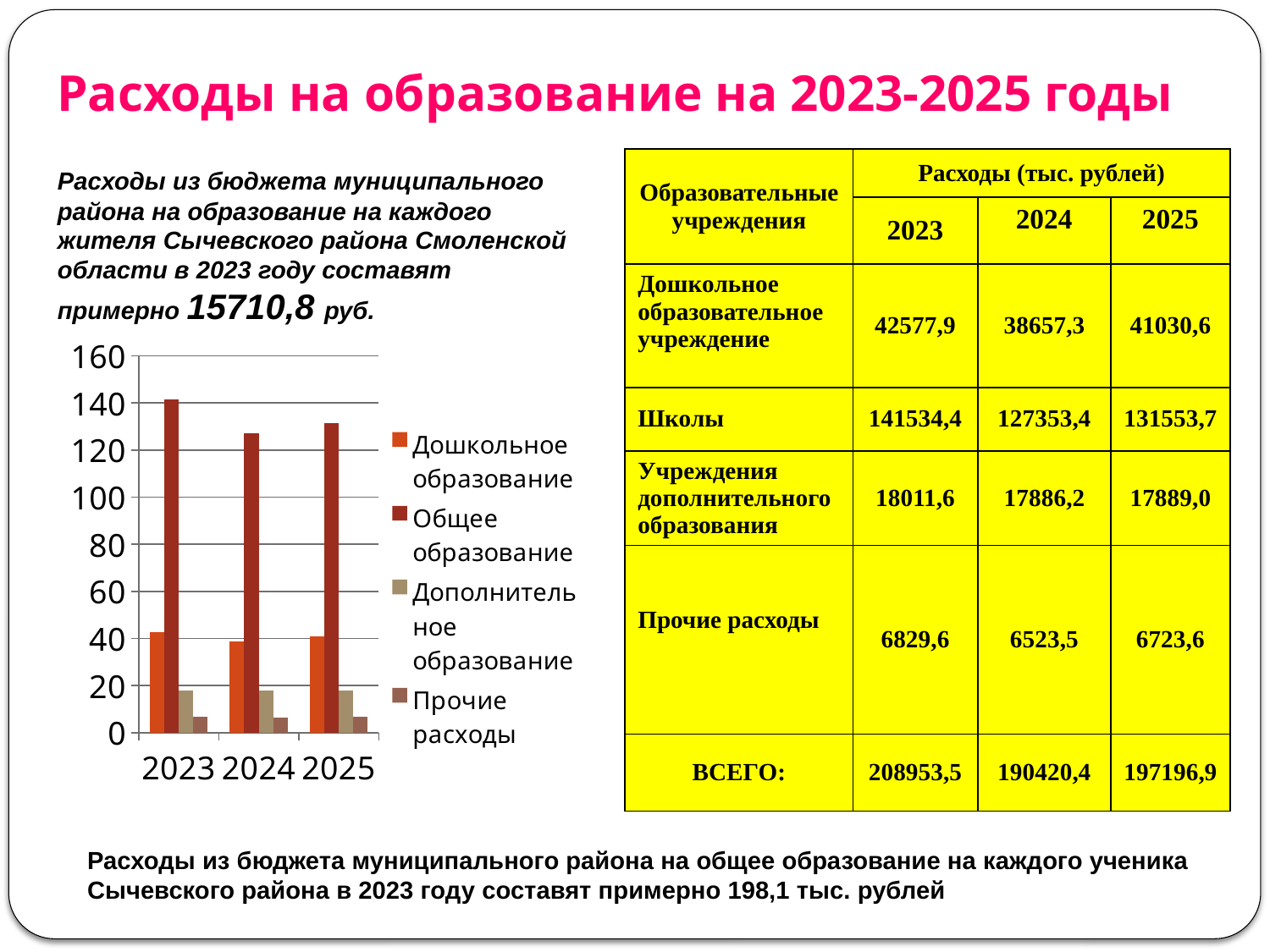
How many series does the chart legend list? 4 What is the highest value shown on the chart's vertical axis? 160 How many years are shown on the x axis of the chart? 3 In which year is the bar for Общее образование the highest? 2023 Is the value for Общее образование in 2024 greater or less than 140? less Which series has the tallest bar in every year of the chart? Общее образование Is the value for Дополнительное образование in 2023 greater or less than 20? less In which year is the bar for Общее образование the lowest? 2024 Which series has the shortest bar in every year of the chart? Прочие расходы What kind of chart is shown on the slide? bar chart Is the value for Общее образование in 2023 greater or less than 120? greater In 2025, which is larger: the bar for Дошкольное образование or the bar for Дополнительное образование? Дошкольное образование